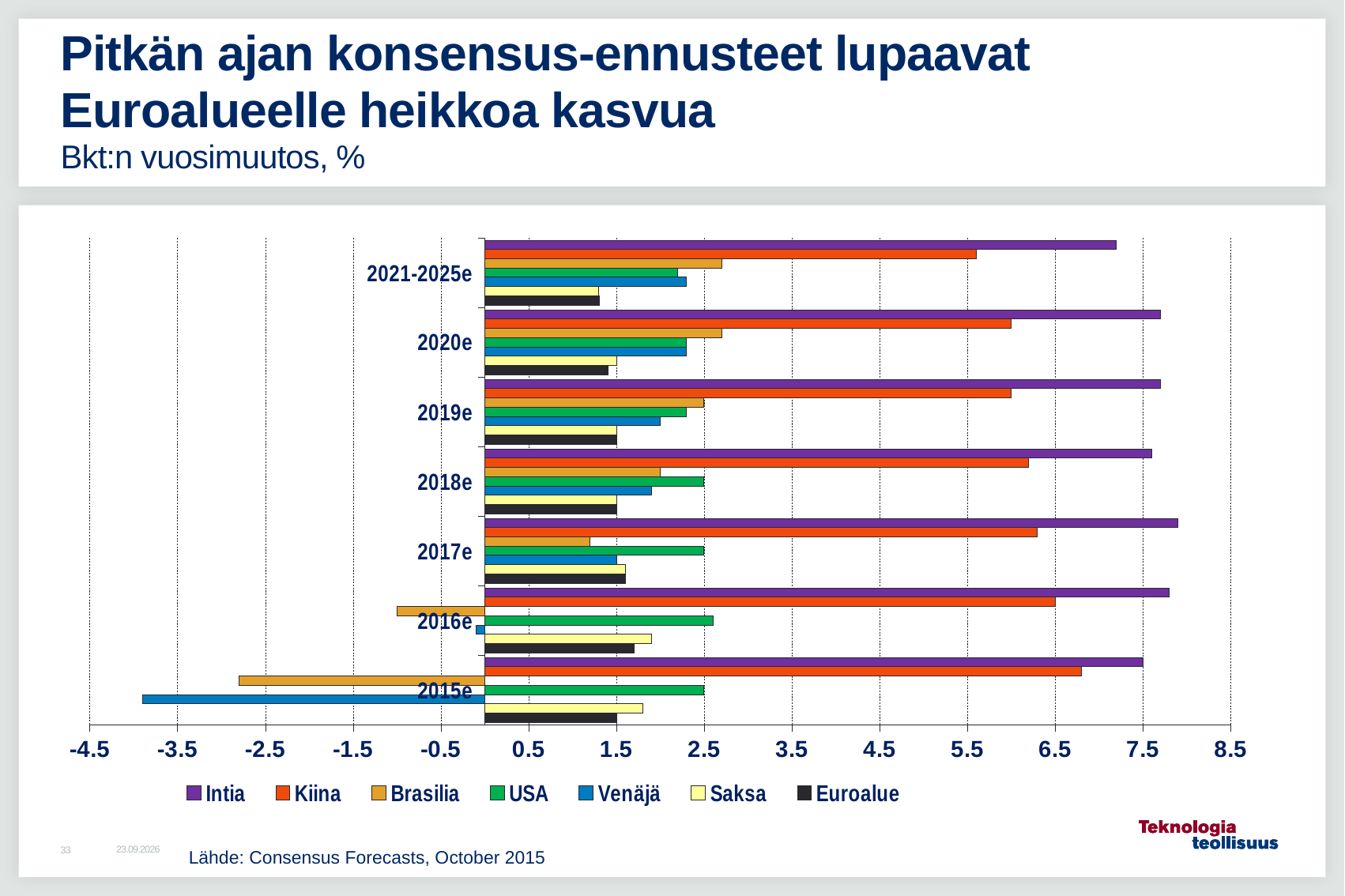
How many series does the legend list? 7 What is the subtitle describing the measure plotted on the chart? Bkt:n vuosimuutos, % Which is larger in 2015e, the value for Intia or the value for Kiina? Intia Is the value for Kiina in 2017e greater or less than 6.5? less Is the value for Venäjä in 2015e greater or less than -3.5? less Which country has the lowest value for 2015e? Venäjä How many year categories are shown on the chart? 7 Which country has the highest value for 2015e? Intia What kind of chart is shown on the slide? bar chart Is the value for Brasilia in 2015e greater or less than -2.5? less Does the value for Brasilia rise or fall from 2015e to 2017e? rise